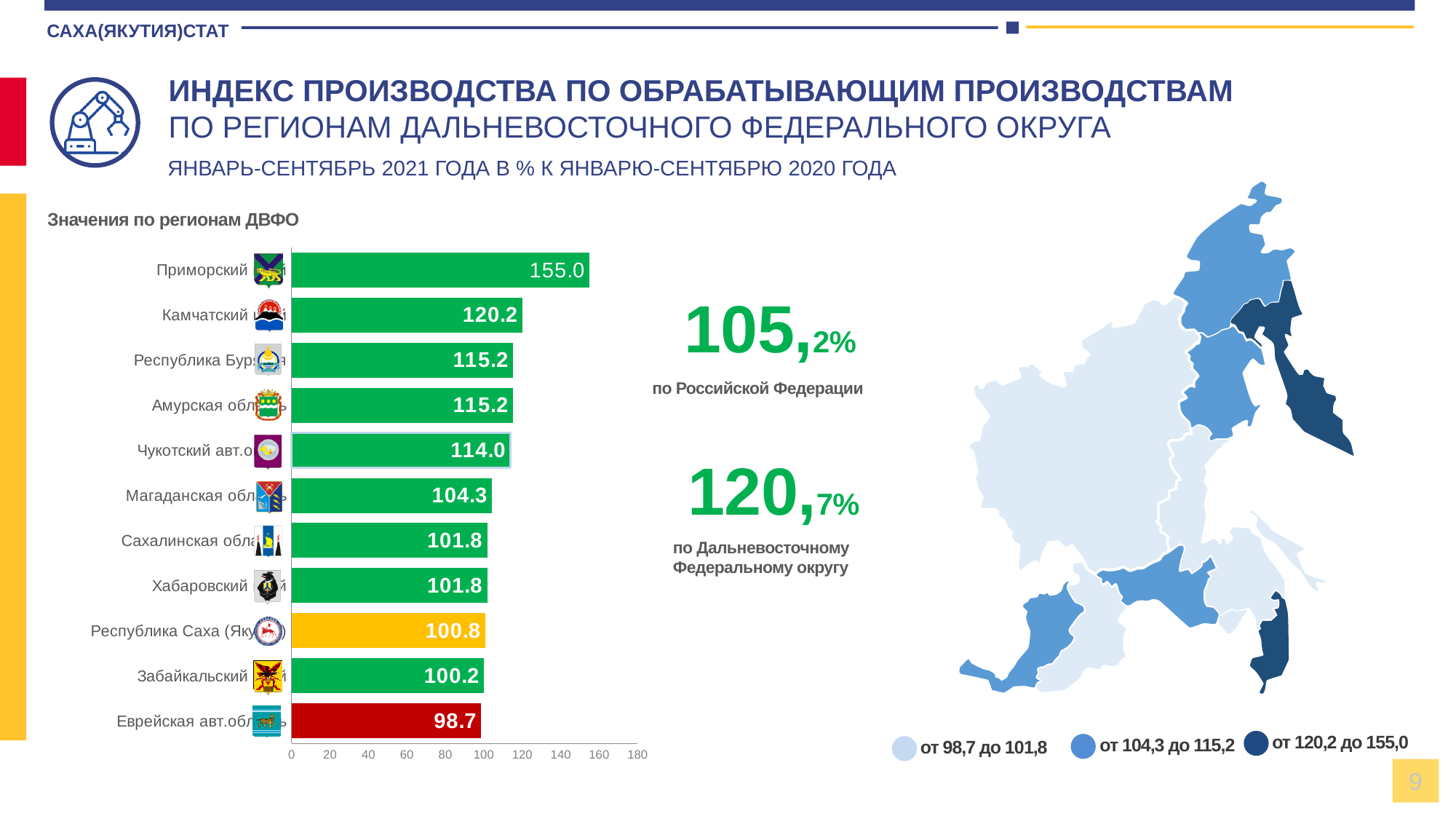
What is the difference between the values for Приморский край and Камчатский край? 34.8 What is the value for Республика Саха (Якутия) in the bar chart? 100.8 Which region has the highest value in the bar chart? Приморский край Which region has the lowest value in the bar chart? Еврейская авт.область How many regions are shown in the bar chart? 11 What colour is the bar for Еврейская авт.область? red What is the value for Приморский край in the bar chart? 155.0 What is the value for Магаданская область in the bar chart? 104.3 What is the value for Чукотский авт.округ in the bar chart? 114.0 What kind of chart is used to show the values by region? bar chart Which is larger, the value for Камчатский край or the value for Республика Бурятия? Камчатский край What is the difference between the values for Чукотский авт.округ and Еврейская авт.область? 15.3